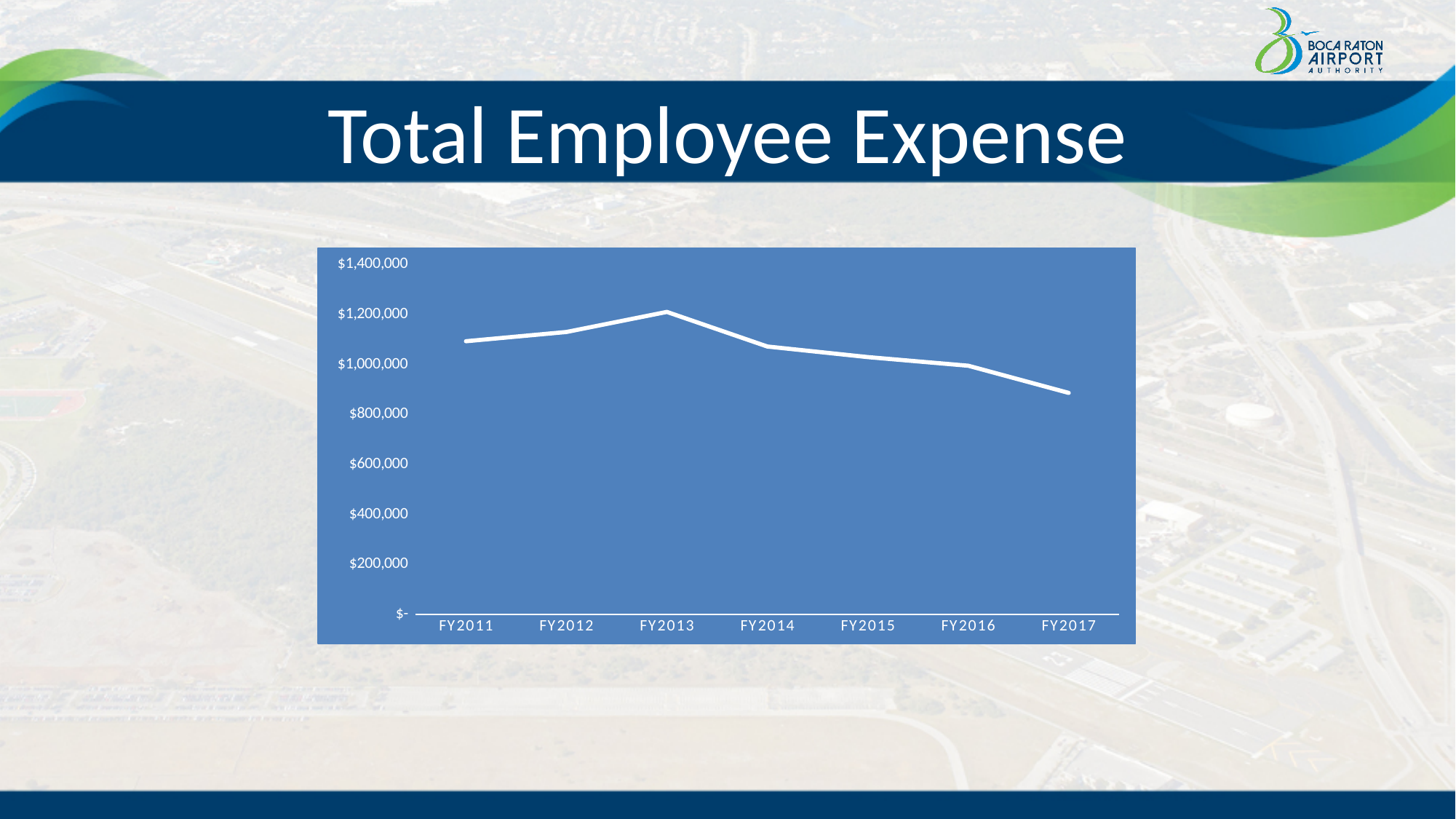
Which is larger, the value for FY2013 or the value for FY2017? FY2013 Does the total employee expense rise or fall from FY2013 to FY2017? fall How many fiscal years are plotted on the x axis? 7 Is the value for FY2017 greater or less than $1,000,000? less What is the highest value shown on the y axis? $1,400,000 Which fiscal year has the lowest total employee expense? FY2017 Which fiscal year has the highest total employee expense? FY2013 What kind of chart is shown on the slide? line chart Is the value for FY2011 greater or less than $1,000,000? greater Is the value for FY2017 greater or less than $800,000? greater What is the title of the slide containing the chart? Total Employee Expense